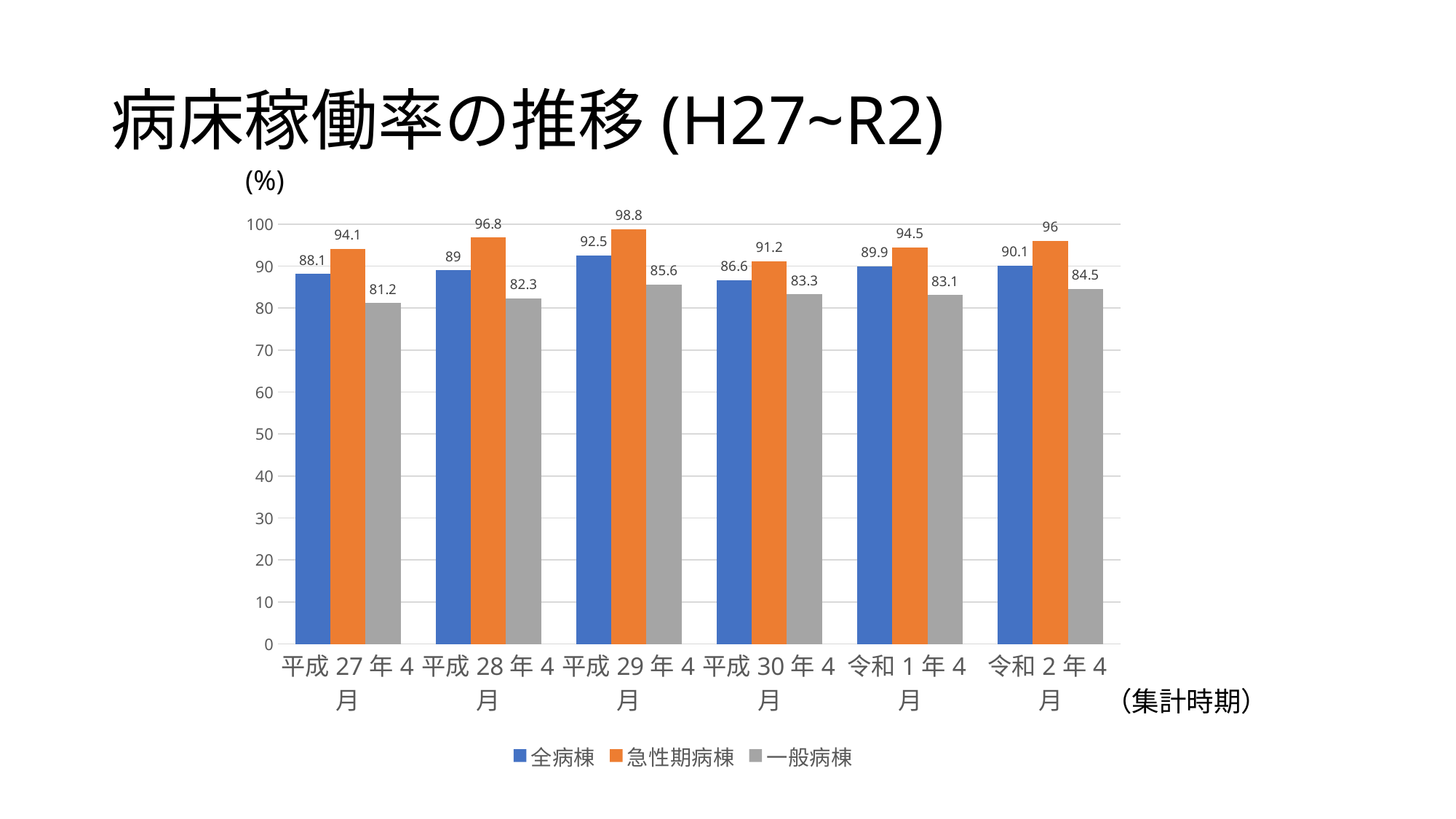
How many series does the legend list? 3 What is the difference between the 急性期病棟 and 一般病棟 values in 平成30年4月? 7.9 What is the value for 一般病棟 in 平成27年4月? 81.2 In which period is the 急性期病棟 value highest? 平成29年4月 What kind of chart is shown on the slide? Bar chart What is the title of the slide? 病床稼働率の推移 (H27~R2) How many time periods are shown on the x axis? 6 Which is larger, the 全病棟 value in 平成28年4月 or in 令和1年4月? 令和1年4月 Does the 一般病棟 value rise or fall from 平成27年4月 to 平成29年4月? Rise What is the value for 全病棟 in 令和2年4月? 90.1 What is the value for 急性期病棟 in 平成29年4月? 98.8 In which period is the 一般病棟 value lowest? 平成27年4月